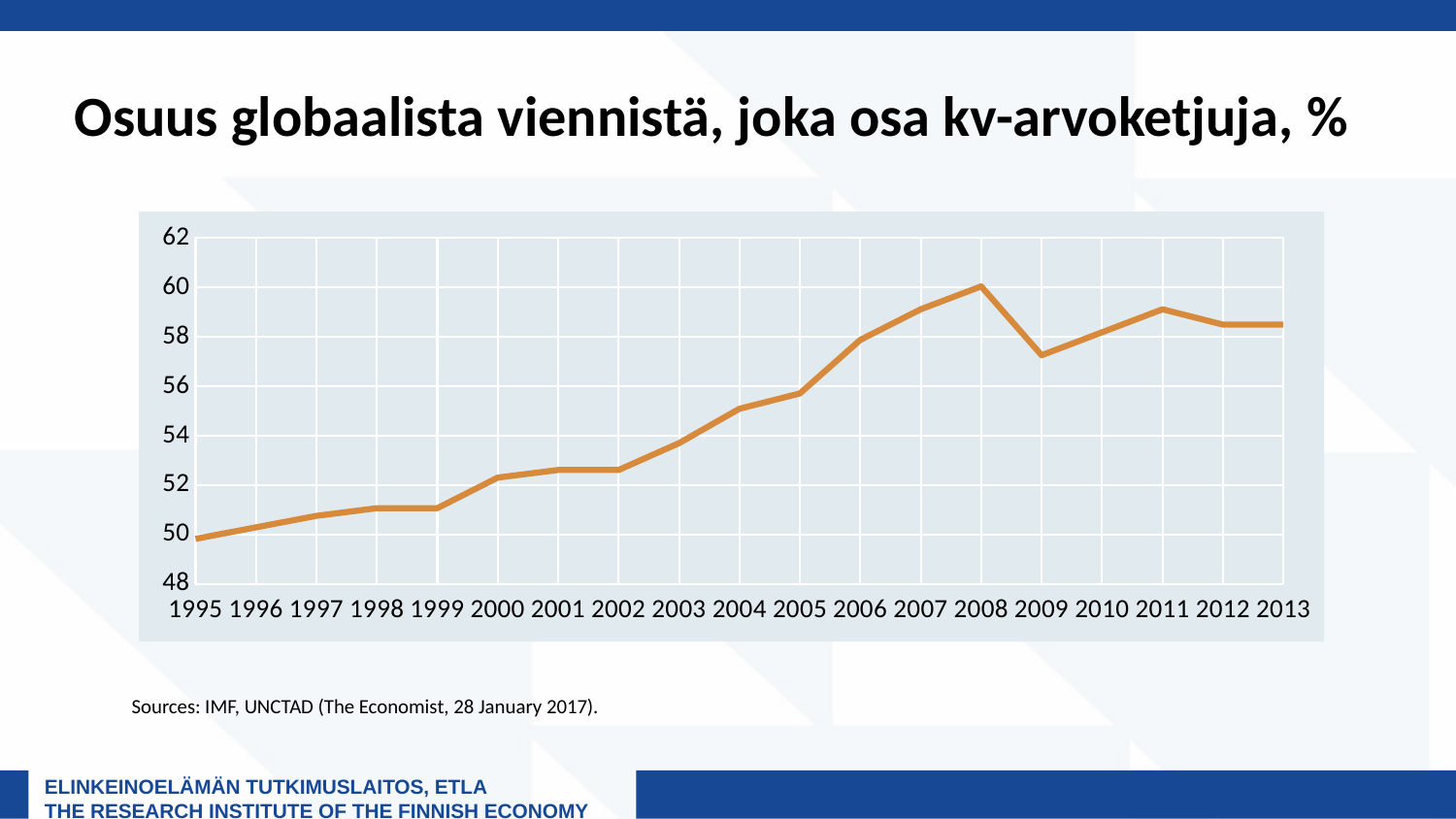
Is the value for 2008 greater or less than 58? greater Which year has the larger value, 2011 or 2009? 2011 Is the value for 2006 greater or less than 56? greater Is the value for 2009 greater or less than 58? less What is the title of the chart? Osuus globaalista viennistä, joka osa kv-arvoketjuja, % Which year has the lowest value? 1995 How many years are plotted on the x axis? 19 Does the value rise or fall from 1995 to 2008? Rise Which year has the larger value, 2008 or 2009? 2008 What kind of chart is shown on the slide? Line chart Which year has the highest value? 2008